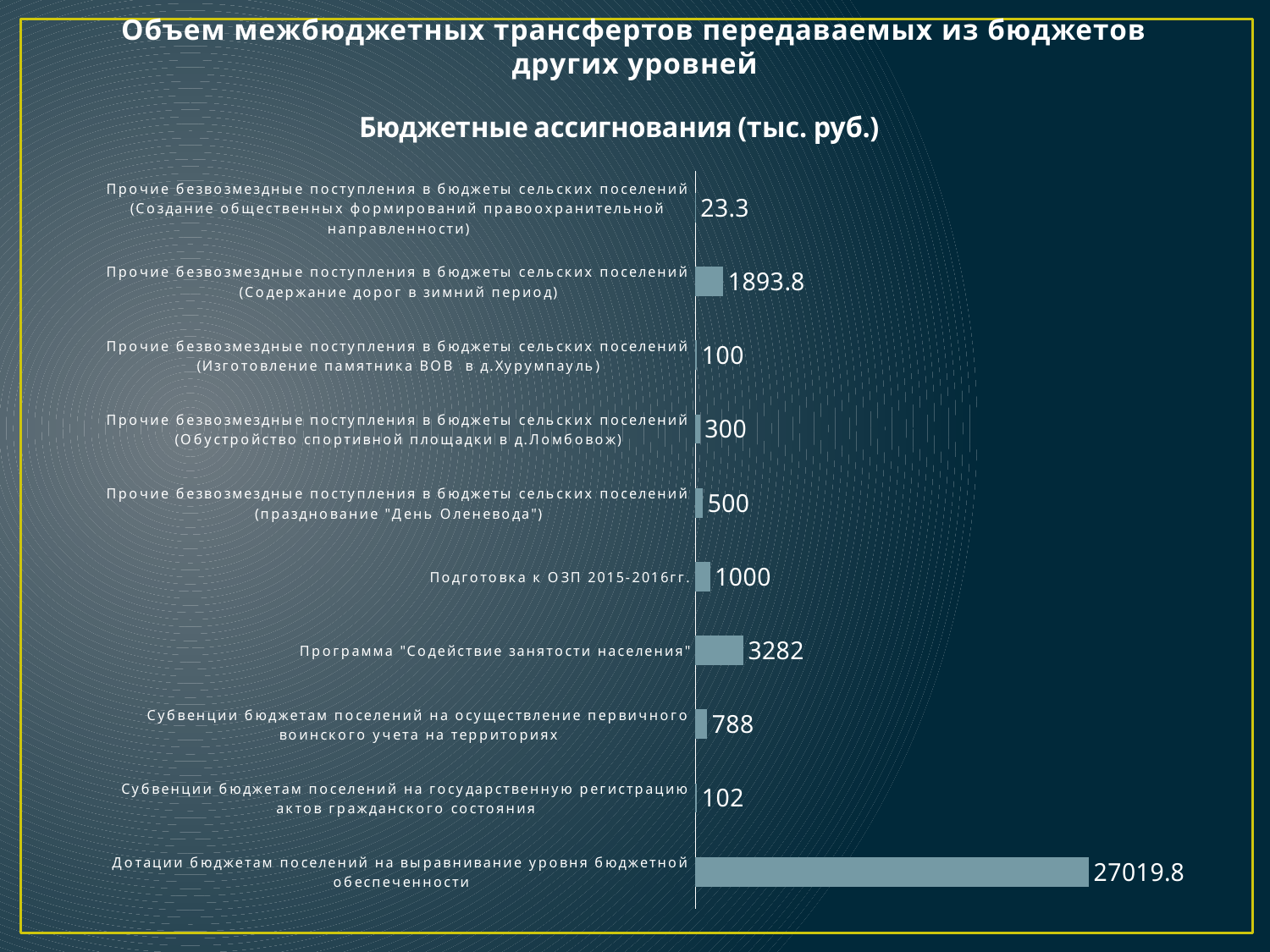
What is the value for "Прочие безвозмездные поступления в бюджеты сельских поселений (Содержание дорог в зимний период)"? 1893.8 How many categories are shown in the chart? 10 What is the difference between the values for "Прочие безвозмездные поступления в бюджеты сельских поселений (Содержание дорог в зимний период)" and "Прочие безвозмездные поступления в бюджеты сельских поселений (Создание общественных формирований правоохранительной направленности)"? 1870.5 Which category has the highest value? Дотации бюджетам поселений на выравнивание уровня бюджетной обеспеченности What is the title of the chart? Бюджетные ассигнования (тыс. руб.) Which is larger: the value for "Субвенции бюджетам поселений на осуществление первичного воинского учета на территориях" or the value for "Прочие безвозмездные поступления в бюджеты сельских поселений (празднование "День Оленевода")"? Субвенции бюджетам поселений на осуществление первичного воинского учета на территориях What is the value for "Подготовка к ОЗП 2015-2016гг."? 1000 Which category has the lowest value? Прочие безвозмездные поступления в бюджеты сельских поселений (Создание общественных формирований правоохранительной направленности) What is the value for "Дотации бюджетам поселений на выравнивание уровня бюджетной обеспеченности"? 27019.8 What is the difference between the values for "Программа "Содействие занятости населения"" and "Подготовка к ОЗП 2015-2016гг."? 2282 What kind of chart is shown on the slide? Bar chart What is the value for "Программа "Содействие занятости населения""? 3282